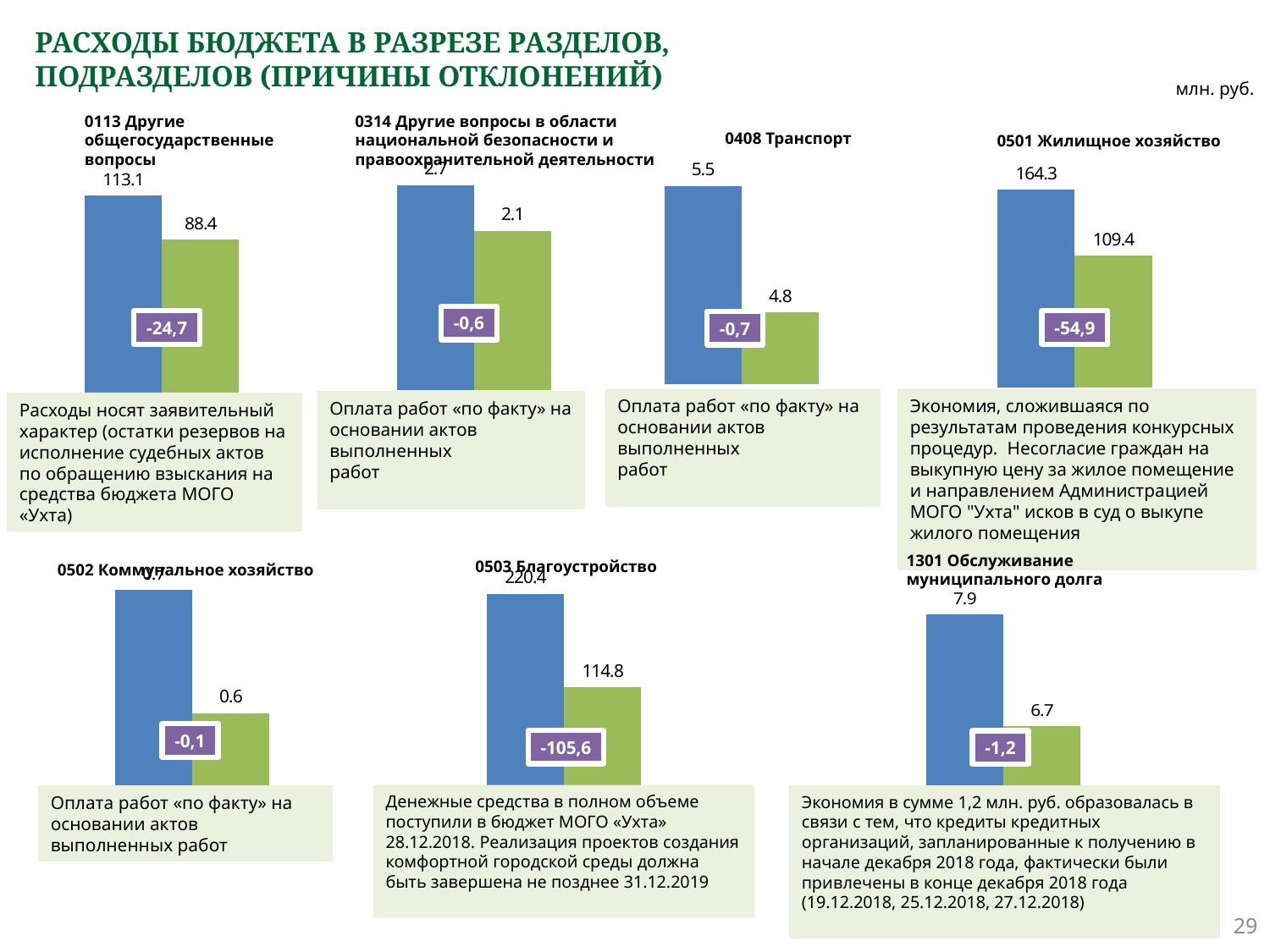
How many separate bar charts are shown on the slide? 7 In the chart titled "0314 Другие вопросы в области национальной безопасности и правоохранительной деятельности", what is the value of the green bar? 2.1 In the chart titled "1301 Обслуживание муниципального долга", which bar is taller, the blue one or the green one? the blue one In the chart titled "0113 Другие общегосударственные вопросы", what is the difference between the blue bar and the green bar? 24.7 In the chart titled "0408 Транспорт", what is the value of the blue bar? 5.5 In the chart titled "0501 Жилищное хозяйство", what is the difference between the blue bar and the green bar? 54.9 In the chart titled "0503 Благоустройство", what is the difference between the blue bar and the green bar? 105.6 In the chart titled "0503 Благоустройство", what is the value of the blue bar? 220.4 In the chart titled "0502 Коммунальное хозяйство", what is the value of the green bar? 0.6 In the chart titled "0501 Жилищное хозяйство", what is the value of the green bar? 109.4 What kind of chart is used for "0314 Другие вопросы в области национальной безопасности и правоохранительной деятельности"? bar chart How many bars are plotted in the chart titled "0408 Транспорт"? 2